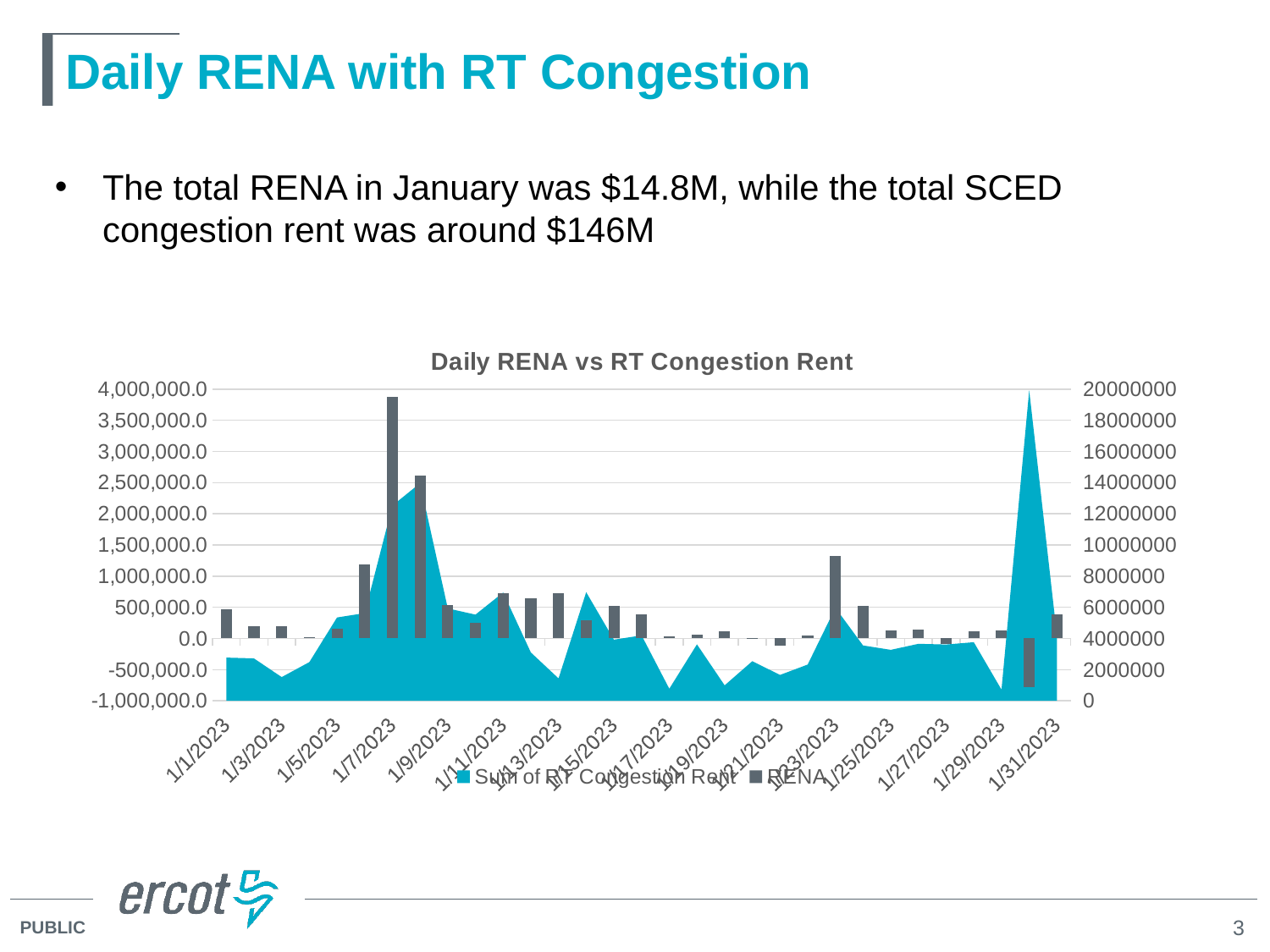
On which date does the RENA series reach its highest value? 1/7/2023 Is the Sum of RT Congestion Rent value for 1/30/2023 greater or less than 16000000 on the right axis? greater What are the two series named in the chart legend? Sum of RT Congestion Rent and RENA Is the RENA value for 1/23/2023 greater or less than 1,000,000.0? greater Which has the larger RENA value, 1/1/2023 or 1/2/2023? 1/1/2023 Is the RENA value for 1/30/2023 greater or less than 0.0? less How many series does the chart legend list? 2 Which has the larger RENA value, 1/7/2023 or 1/8/2023? 1/7/2023 How is the RENA series drawn on the chart? As bars (a bar chart) How many date labels are shown on the x axis of the chart? 16 What is the title of the chart on the slide? Daily RENA vs RT Congestion Rent